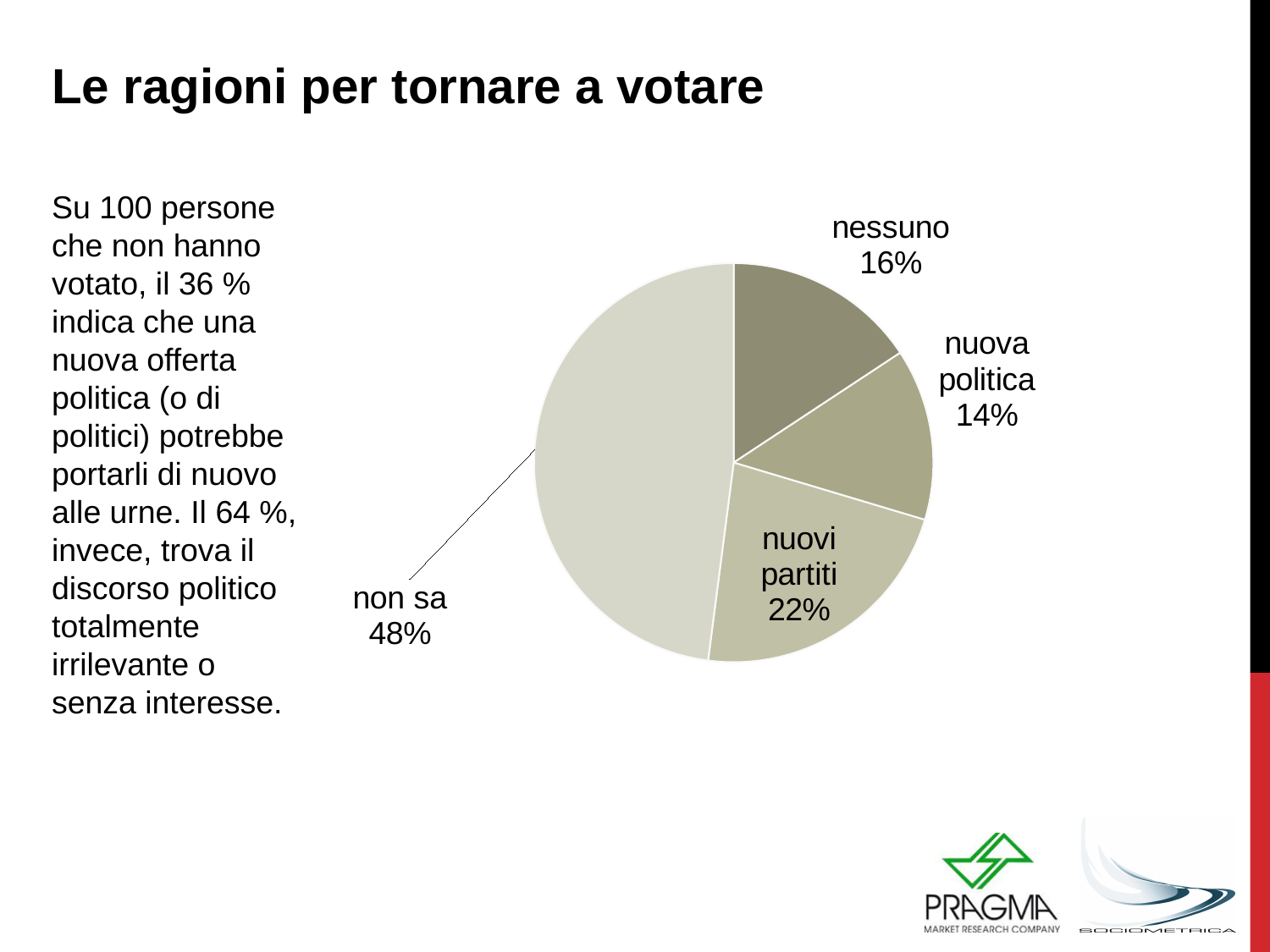
What is the value for "nessuno"? 16% How many slices does the pie chart have? 4 What is the difference between the values for "non sa" and "nuovi partiti"? 26% Which category has the smallest slice of the pie? nuova politica What is the value for "nuovi partiti"? 22% Which category has the largest slice of the pie? non sa What is the value for "nuova politica"? 14% Which is larger, the slice for "nuovi partiti" or the slice for "nessuno"? nuovi partiti What is the title of the slide containing the pie chart? Le ragioni per tornare a votare What kind of chart is shown on the slide? pie chart What share of the pie does "non sa" represent? 48% What is the difference between the values for "nessuno" and "nuova politica"? 2%